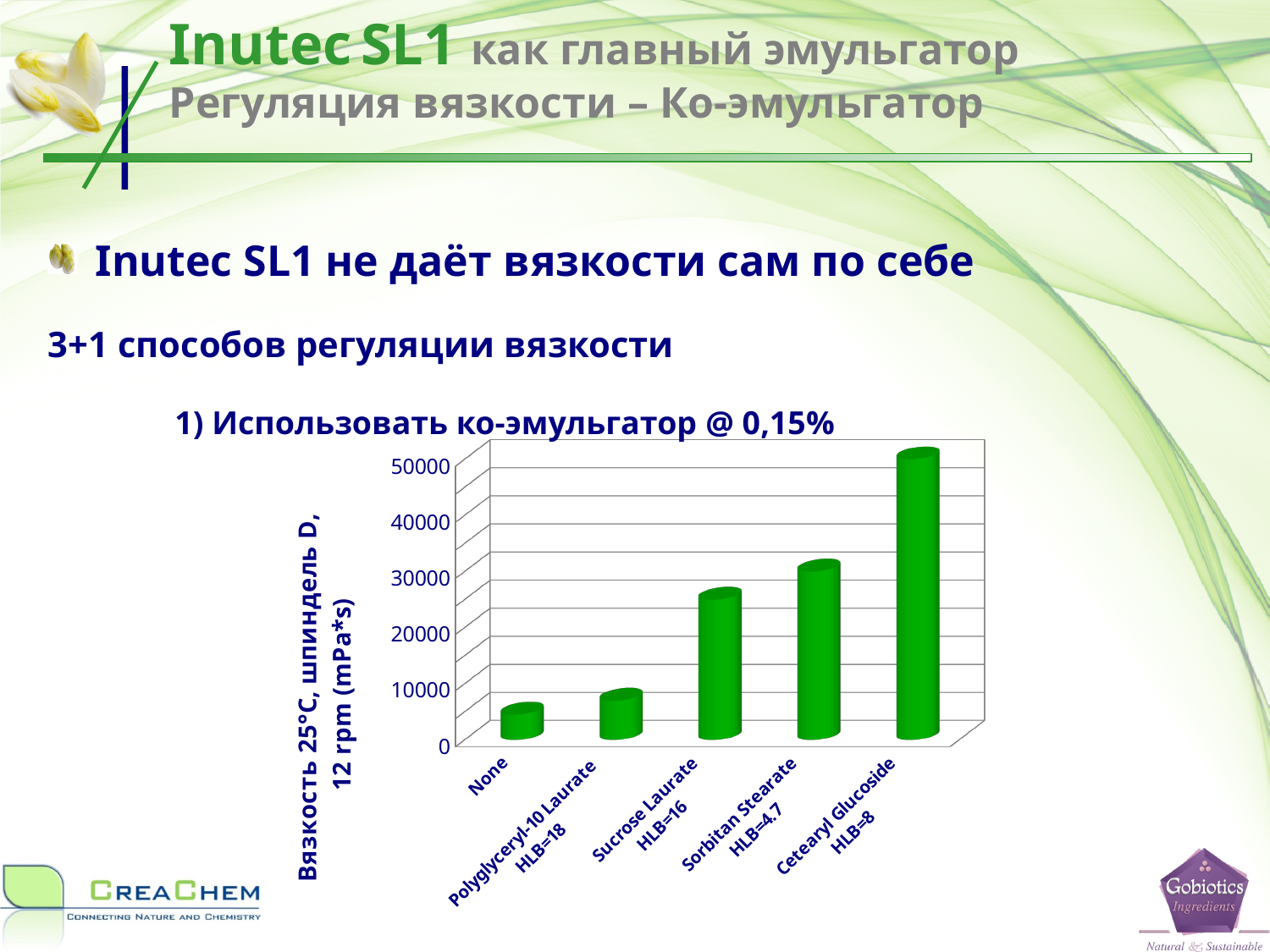
Is the value for Sucrose Laurate HLB=16 greater or less than 20000? greater Is the value for Sorbitan Stearate HLB=4.7 greater or less than 20000? greater Is the value for Cetearyl Glucoside HLB=8 greater or less than 40000? greater How many co-emulsifier categories are plotted on the chart? 5 What is the label of the vertical axis of the chart? Вязкость 25°C, шпиндель D, 12 rpm (mPa*s) Which category has the highest viscosity on the chart? Cetearyl Glucoside HLB=8 Which has the higher viscosity, Sucrose Laurate HLB=16 or Sorbitan Stearate HLB=4.7? Sorbitan Stearate HLB=4.7 What kind of chart is shown on the slide? bar chart Do the bar values rise or fall from left to right along the x axis? rise Which category has the lowest viscosity on the chart? None